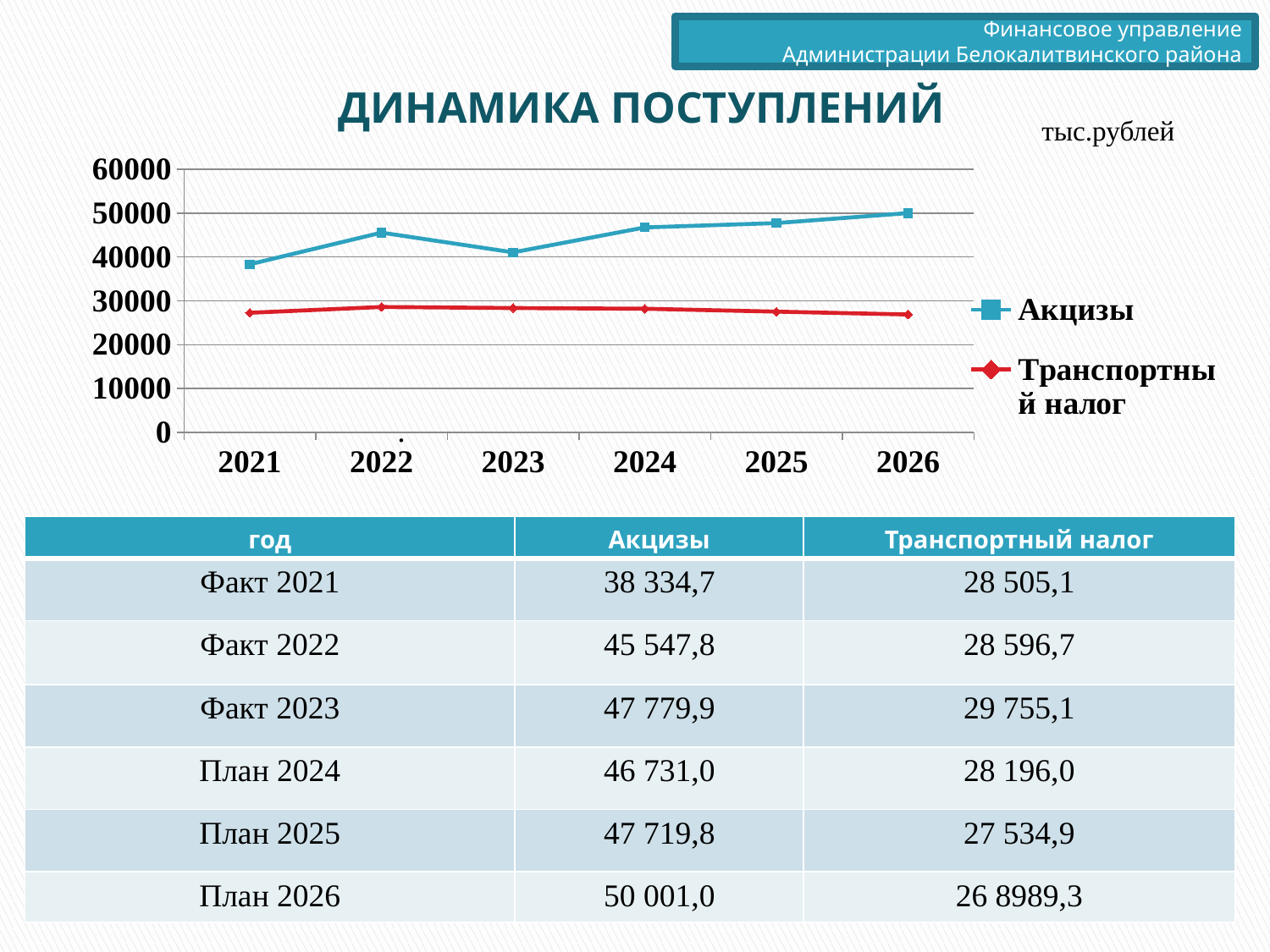
In 2021, which series has the larger value, Акцизы or Транспортный налог? Акцизы What kind of chart is shown on the slide? line chart Which year has the highest value for Акцизы in the chart? 2026 Do the values for Акцизы rise or fall from 2023 to 2026? rise Is the value for Акцизы in 2021 greater or less than 40000? less How many series does the chart legend list? 2 How many years are plotted along the x axis of the chart? 6 What is the title of the chart? ДИНАМИКА ПОСТУПЛЕНИЙ Is the value for Транспортный налог in 2026 greater or less than 20000? greater Which year has the lowest value for Акцизы in the chart? 2021 Is the value for Акцизы in 2022 greater or less than 40000? greater